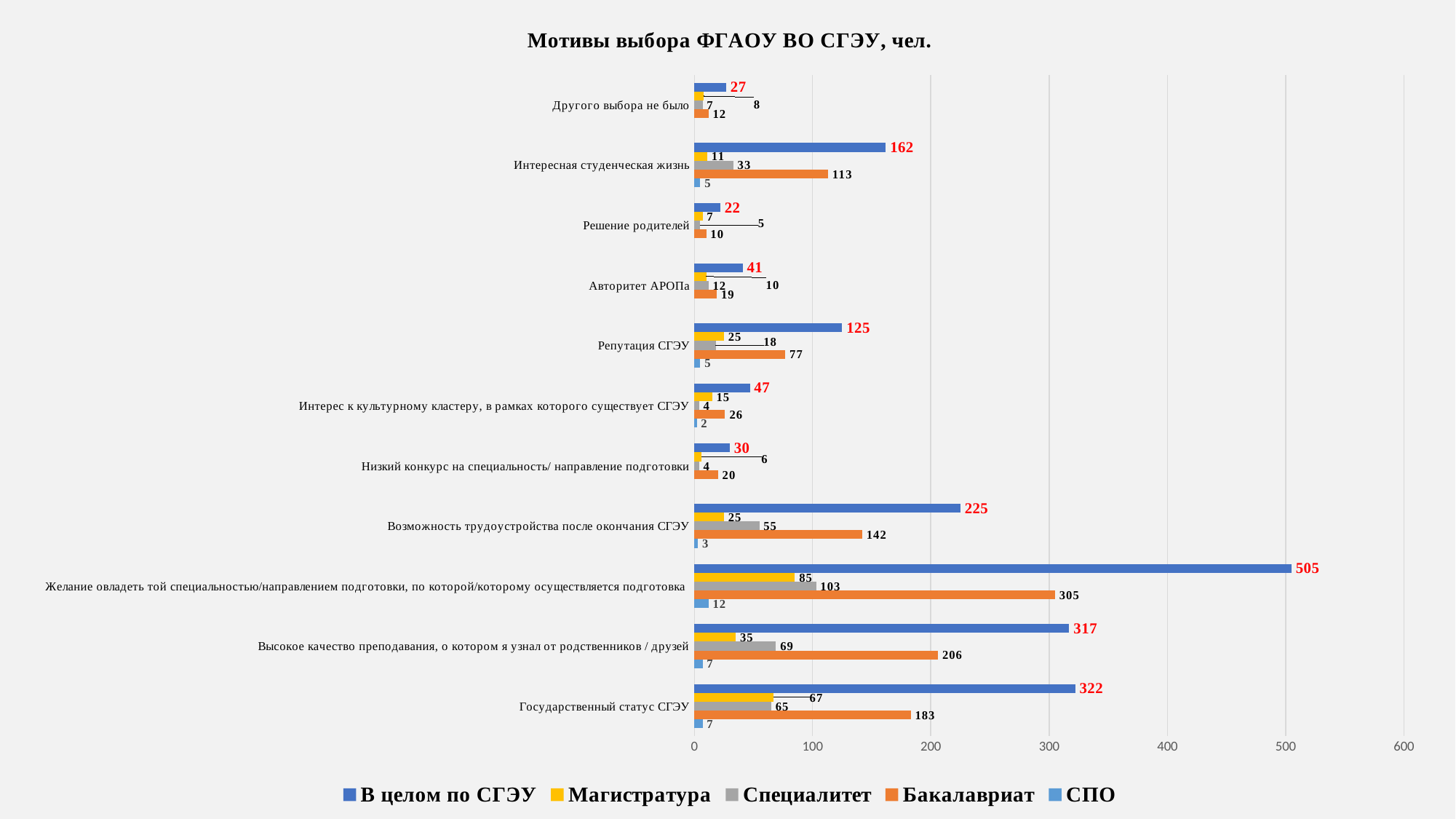
Which is larger for 'Репутация СГЭУ': the 'Магистратура' value or the 'Специалитет' value? Магистратура What is the difference between the 'В целом по СГЭУ' values for 'Государственный статус СГЭУ' and 'Высокое качество преподавания, о котором я узнал от родственников / друзей'? 5 What is the value of 'В целом по СГЭУ' for 'Желание овладеть той специальностью/направлением подготовки, по которой/которому осуществляется подготовка'? 505 What is the title of the chart? Мотивы выбора ФГАОУ ВО СГЭУ, чел. What is the value of 'Специалитет' for 'Возможность трудоустройства после окончания СГЭУ'? 55 Is the 'Бакалавриат' value for 'Интересная студенческая жизнь' greater or less than 100? greater Which category has the highest value for 'В целом по СГЭУ'? Желание овладеть той специальностью/направлением подготовки, по которой/которому осуществляется подготовка What type of chart is shown on the slide? bar chart What is the value of 'Бакалавриат' for 'Высокое качество преподавания, о котором я узнал от родственников / друзей'? 206 Which category has the lowest value for 'В целом по СГЭУ'? Решение родителей How many series does the legend list? 5 How many categories (motives) are shown on the chart? 11